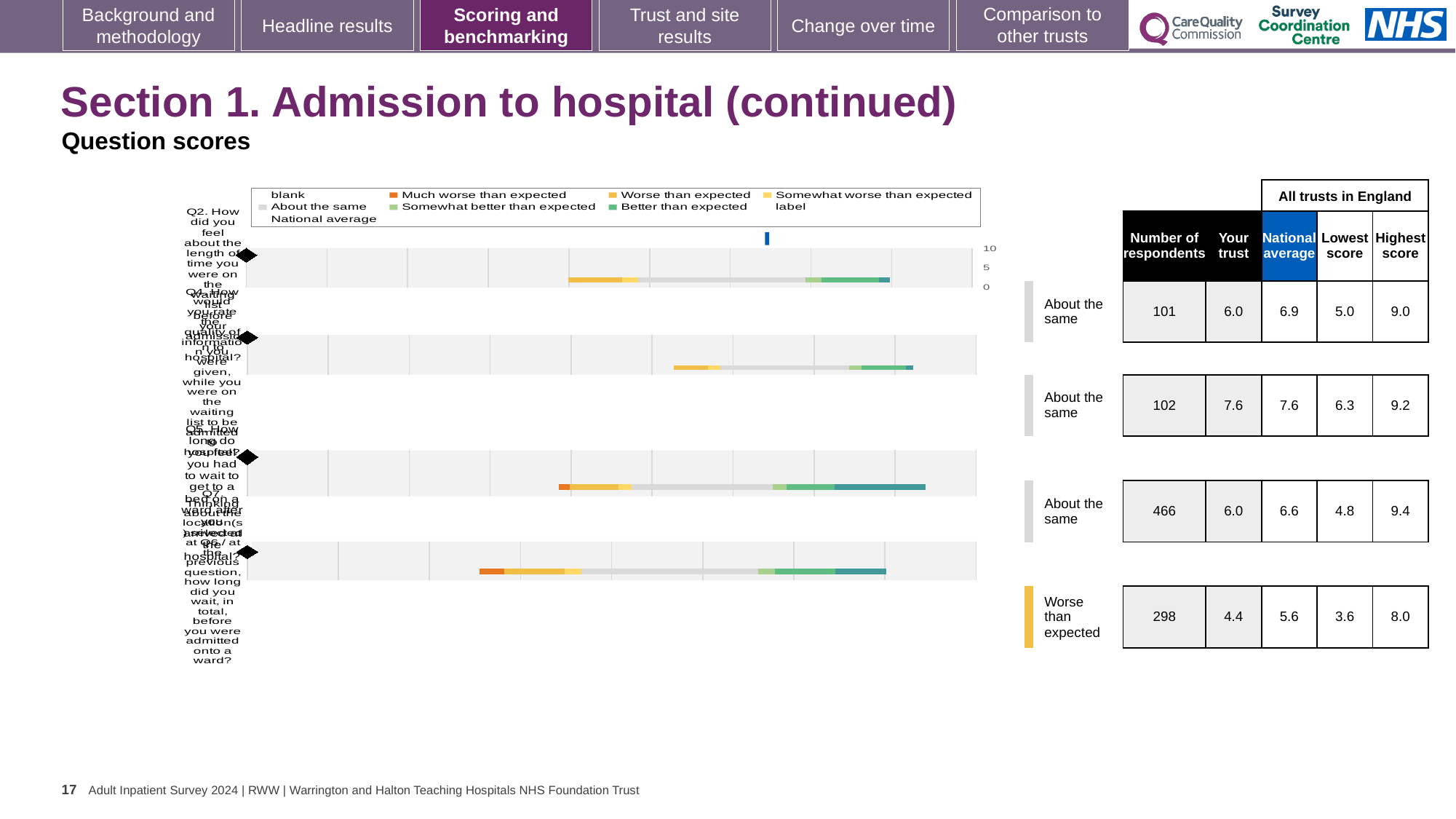
What is the highest score for the third row of the table? 9.4 What is the lowest 'Your trust' score shown in the table? 4.4 For the first row of the table, what is the difference between the highest score and the lowest score? 4.0 Which row of the table has the highest number of respondents? the third row (466) How many question bars are plotted in the chart? 4 For the fourth (bottom) row, how much higher is the national average than the 'Your trust' score? 1.2 In the table, what is the number of respondents for the row rated 'Worse than expected'? 298 In the second row of the table, is the 'Your trust' score higher or lower than the national average? they are equal (7.6) How many of the four rows are rated 'About the same'? 3 What kind of chart is shown on the slide? bar chart What is the national average for the fourth (bottom) row of the table? 5.6 What is the 'Your trust' score for the fourth (bottom) row of the table? 4.4